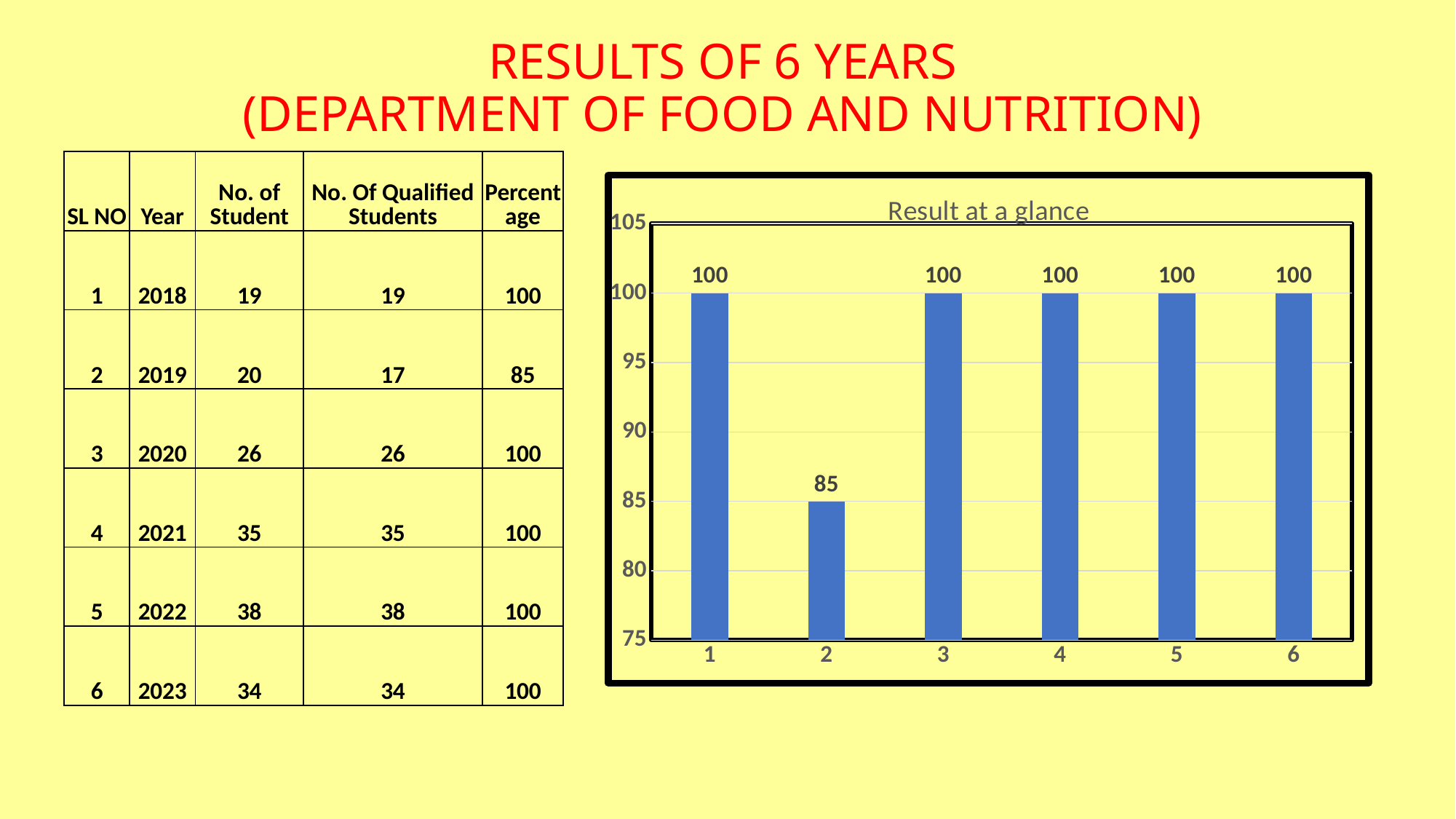
What is the value for category 2 in the chart? 85 How many categories in the chart have a value of 100? 5 What is the value for category 6 in the chart? 100 What is the difference between the values for category 1 and category 2? 15 How many categories are shown on the x axis of the chart? 6 Which is larger, the value for category 2 or the value for category 3? 3 Is the value for category 5 greater or less than 95? greater What is the value for category 4 in the chart? 100 What is the title of the chart? Result at a glance Which category has the lowest value in the chart? 2 What kind of chart is shown on the slide? bar chart Is the value for category 2 greater or less than 90? less